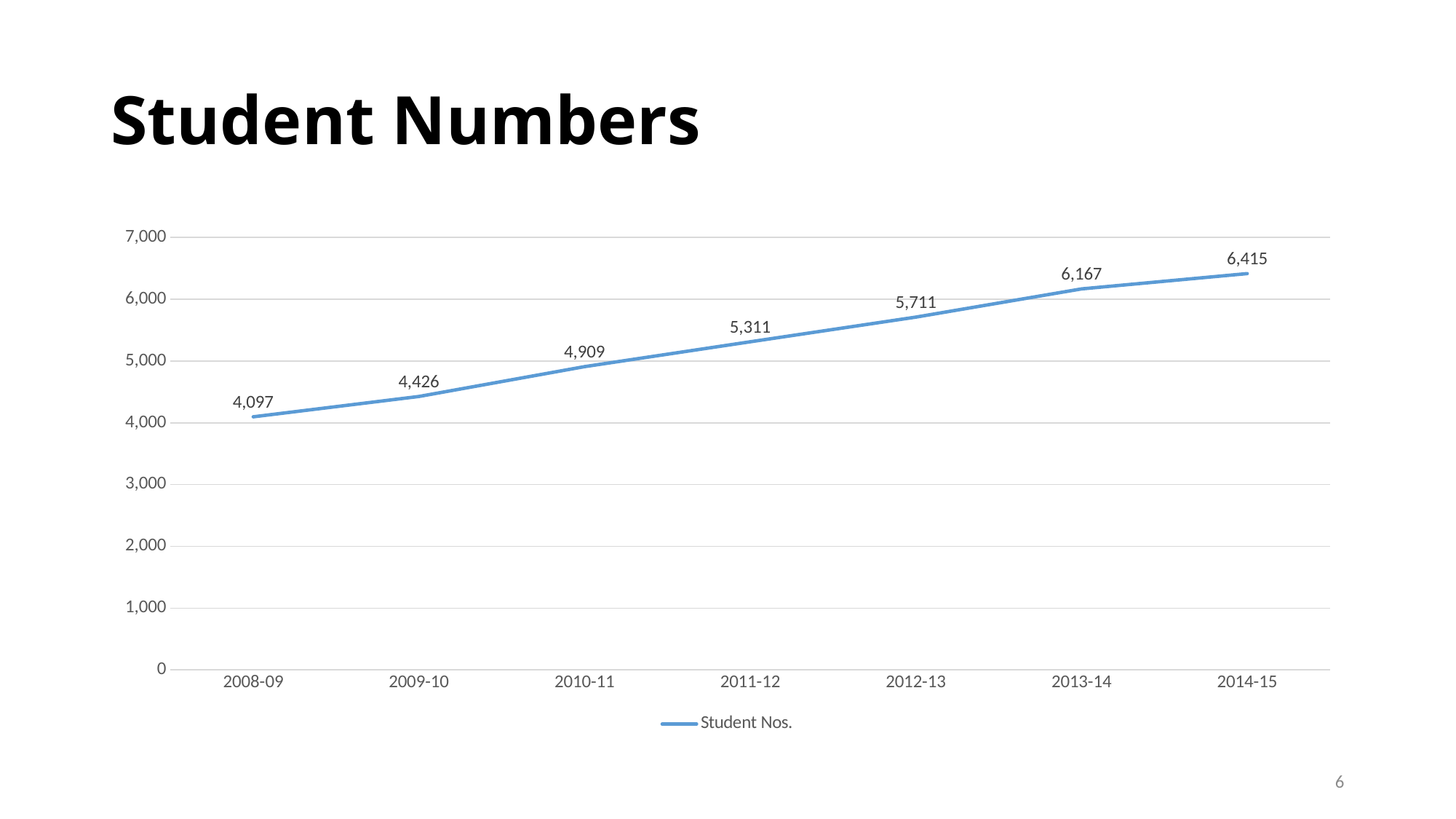
Which year has the lowest number of students? 2008-09 Which year has more students, 2010-11 or 2012-13? 2012-13 Do student numbers rise or fall from 2008-09 to 2014-15? rise What kind of chart is shown on the slide? line chart What is the value for Student Nos. in 2008-09? 4,097 Is the value for 2013-14 greater or less than 6,000? greater What is the difference in student numbers between 2013-14 and 2012-13? 456 How many years are plotted on the x axis? 7 What is the value for Student Nos. in 2014-15? 6,415 What is the value for Student Nos. in 2011-12? 5,311 Which year has the highest number of students? 2014-15 What is the difference in student numbers between 2014-15 and 2008-09? 2,318